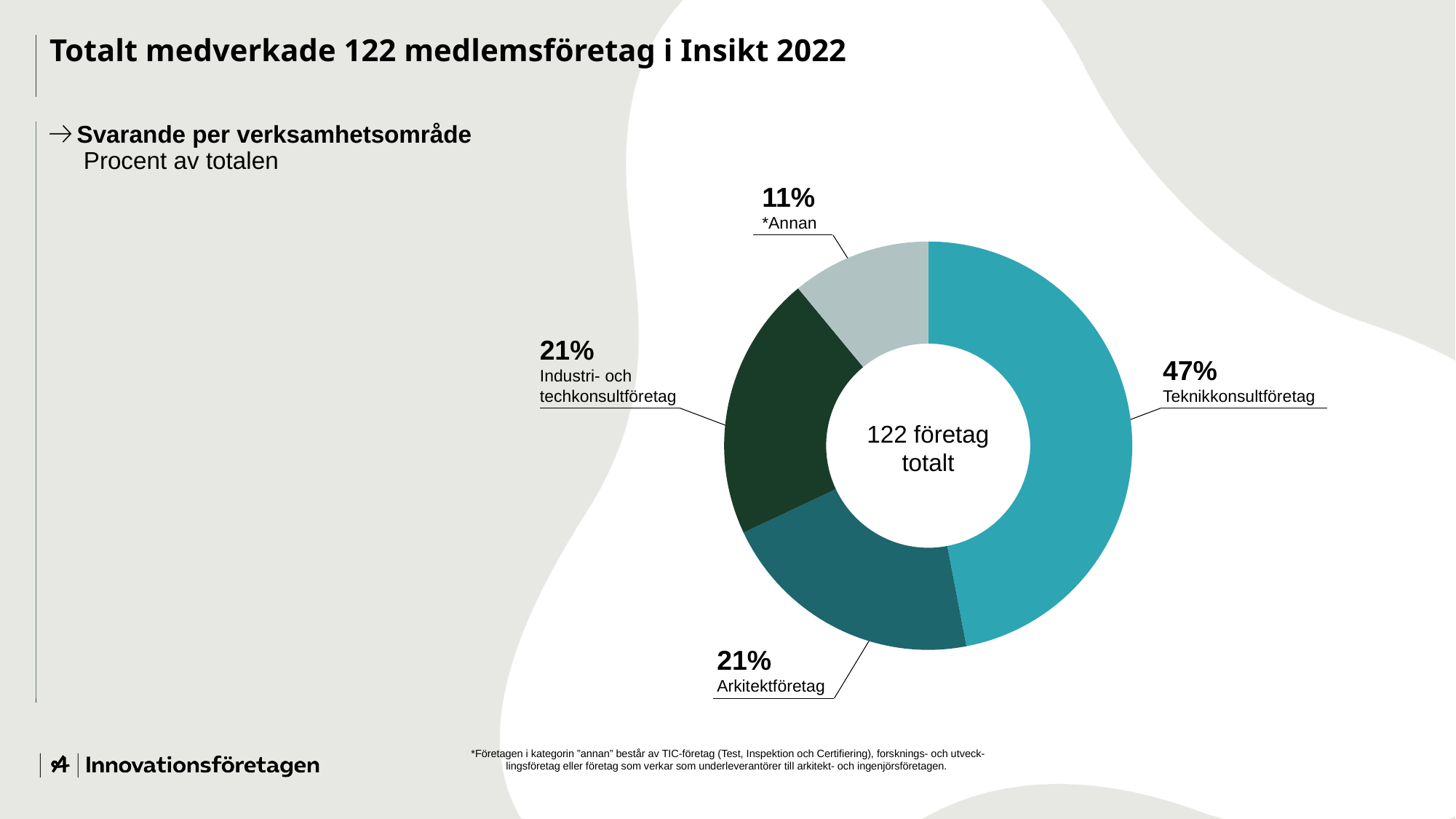
What share of the respondents are Industri- och techkonsultföretag? 21% What is the difference in percentage points between Industri- och techkonsultföretag and *Annan? 10 Which category has the smallest share of respondents? *Annan What share of the respondents are Teknikkonsultföretag? 47% What total number of companies is shown in the centre of the chart? 122 företag totalt What share of the respondents are Arkitektföretag? 21% What kind of chart is shown on the slide? Doughnut chart How many categories are shown in the chart? 4 What is the difference in percentage points between Teknikkonsultföretag and Arkitektföretag? 26 What share of the respondents fall in the *Annan category? 11% Which category has the largest share of respondents? Teknikkonsultföretag Which has a larger share, Teknikkonsultföretag or *Annan? Teknikkonsultföretag